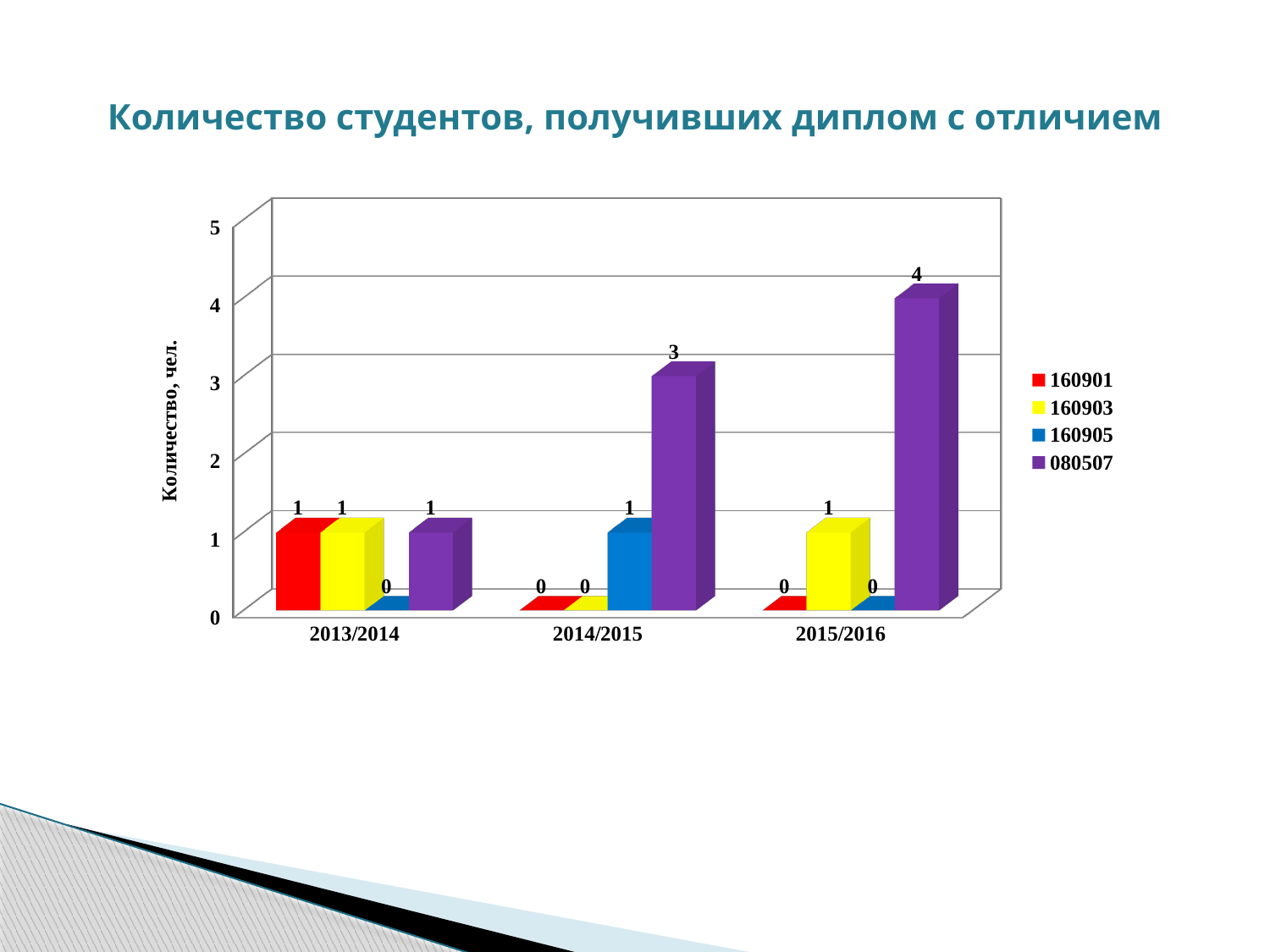
What kind of chart is shown on the slide? Bar chart How many series does the legend list? 4 What is the value for 160903 in 2015/2016? 1 In which academic year is the value for 080507 lowest? 2013/2014 Which is larger in 2014/2015: the value for 160905 or the value for 080507? 080507 Do the values for 080507 rise or fall from 2013/2014 to 2015/2016? Rise In which academic year is the value for 080507 highest? 2015/2016 What is the value for 080507 in 2014/2015? 3 What is the difference between the 080507 values for 2015/2016 and 2014/2015? 1 What is the value for 080507 in 2015/2016? 4 How many academic years are shown on the x axis? 3 What is the value for 160905 in 2013/2014? 0